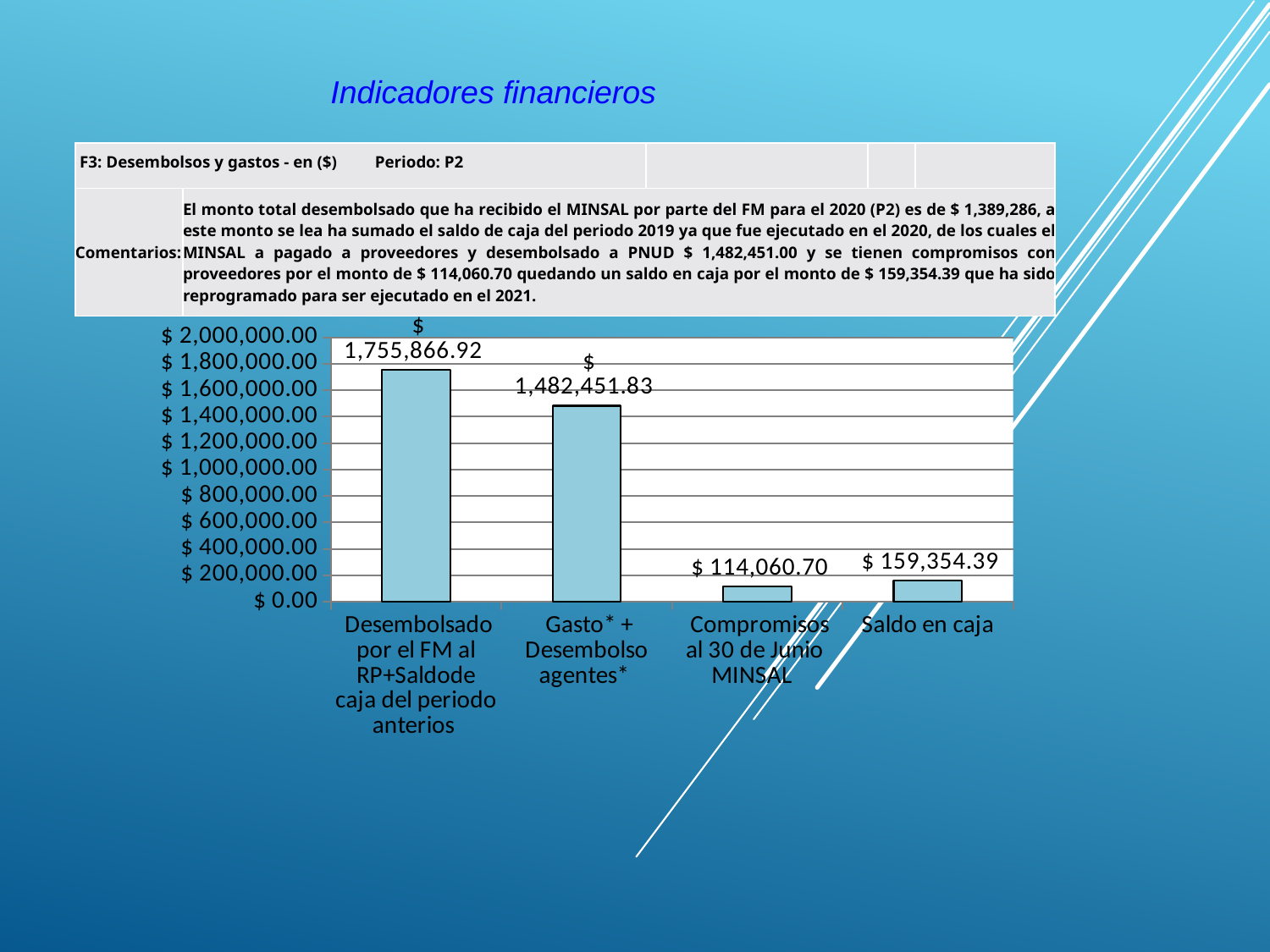
Which category has the lowest value in the chart? Compromisos al 30 de Junio MINSAL What is the value of the bar labelled "Saldo en caja"? $ 159,354.39 Which is larger, the value for "Saldo en caja" or the value for "Compromisos al 30 de Junio MINSAL"? Saldo en caja How many bars (categories) does the chart show? 4 What is the value of the bar labelled "Gasto* + Desembolso agentes*"? $ 1,482,451.83 What is the value of the bar labelled "Compromisos al 30 de Junio MINSAL"? $ 114,060.70 Which category has the highest value in the chart? Desembolsado por el FM al RP+Saldode caja del periodo anterios What is the value of the bar labelled "Desembolsado por el FM al RP+Saldode caja del periodo anterios"? $ 1,755,866.92 What kind of chart is shown on the slide? bar chart Is the value for "Gasto* + Desembolso agentes*" greater or less than $ 1,400,000.00? greater What is the difference between the "Saldo en caja" bar and the "Compromisos al 30 de Junio MINSAL" bar? $ 45,293.69 What is the difference between the "Desembolsado por el FM al RP+Saldode caja del periodo anterios" bar and the "Gasto* + Desembolso agentes*" bar? $ 273,415.09